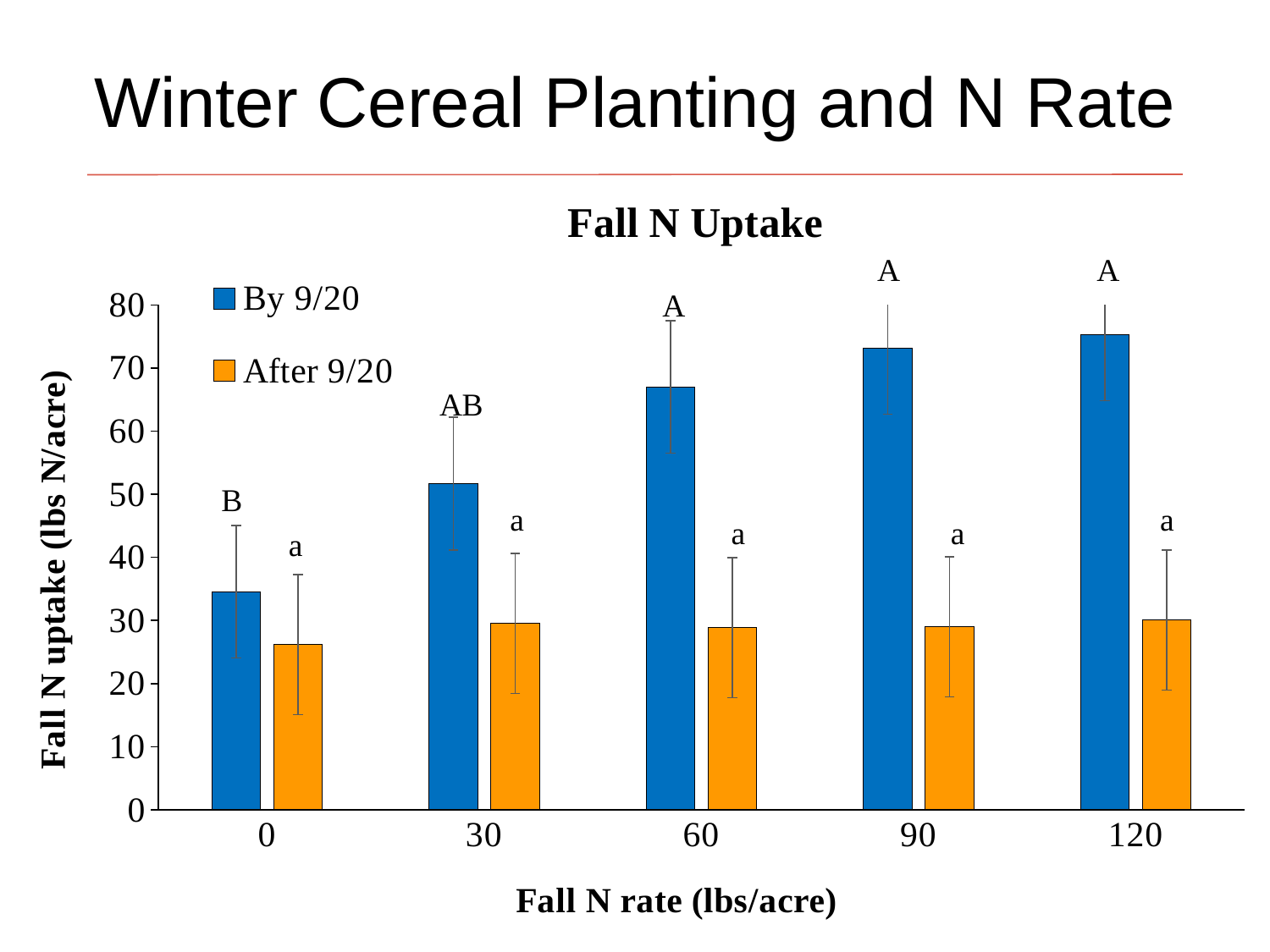
What is the title of the chart? Fall N Uptake At a Fall N rate of 60, which series has the larger value, By 9/20 or After 9/20? By 9/20 Is the By 9/20 value at a Fall N rate of 60 greater or less than 60? greater Is the By 9/20 value at a Fall N rate of 90 greater or less than 70? greater How many series does the legend list? 2 What kind of chart is shown on the slide? bar chart Which Fall N rate has the lowest After 9/20 value? 0 Is the After 9/20 value at a Fall N rate of 120 greater or less than 40? less Do the By 9/20 values rise or fall as the Fall N rate increases from 0 to 120? rise Which Fall N rate has the lowest By 9/20 value? 0 How many Fall N rate categories are shown on the x axis? 5